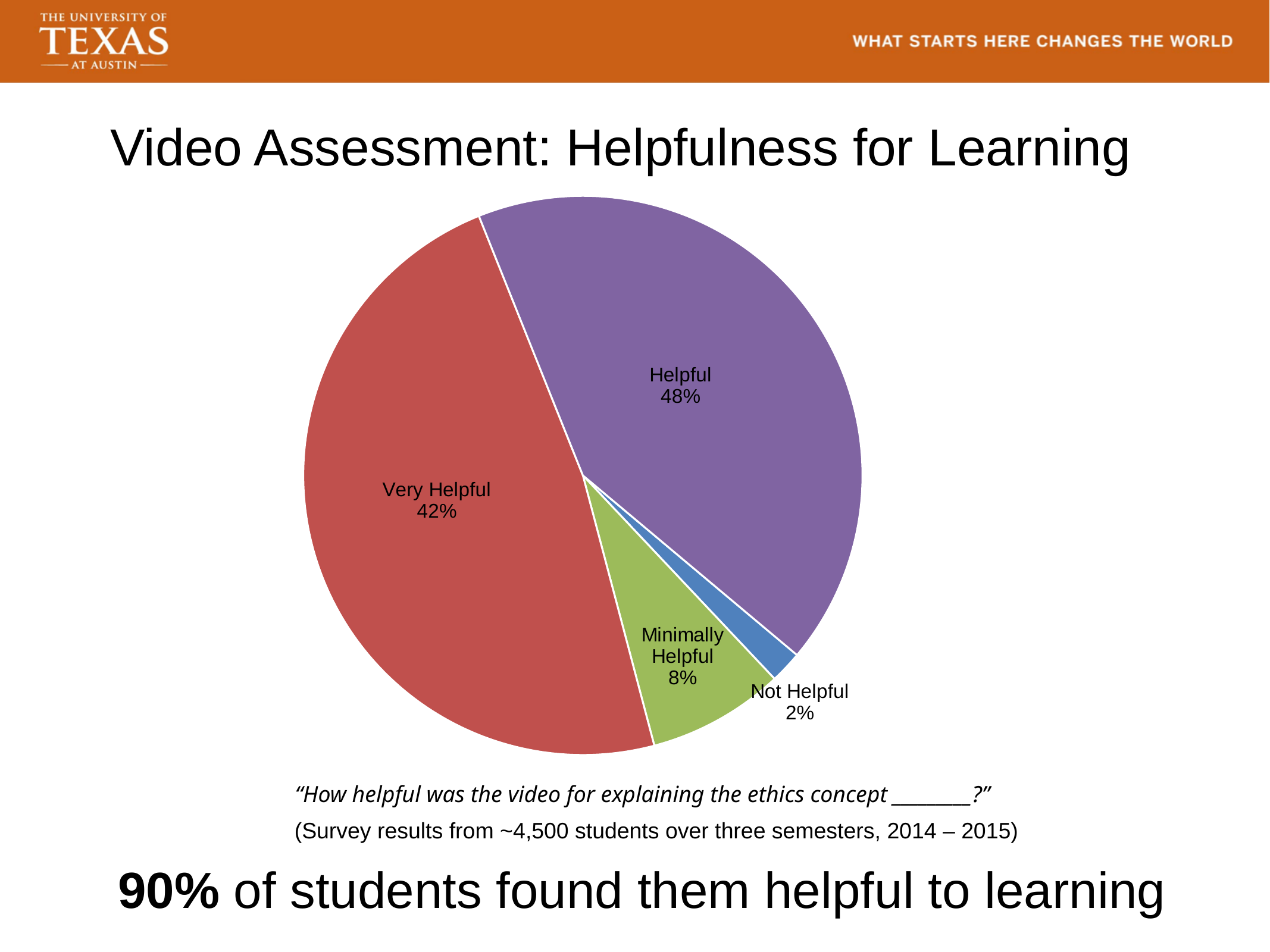
How many categories are shown in the pie chart? 4 Which category has the largest share of the pie? Helpful What percentage of students rated the video as Minimally Helpful? 8% What colour is the Very Helpful slice? Red What is the difference in percentage points between Helpful and Very Helpful? 6 What percentage of students rated the video as Not Helpful? 2% Which is larger, the Minimally Helpful share or the Not Helpful share? Minimally Helpful What kind of chart is shown on the slide? Pie chart Which category has the smallest share of the pie? Not Helpful What percentage of students rated the video as Very Helpful? 42% What is the combined share of Helpful and Very Helpful? 90% What percentage of students rated the video as Helpful? 48%